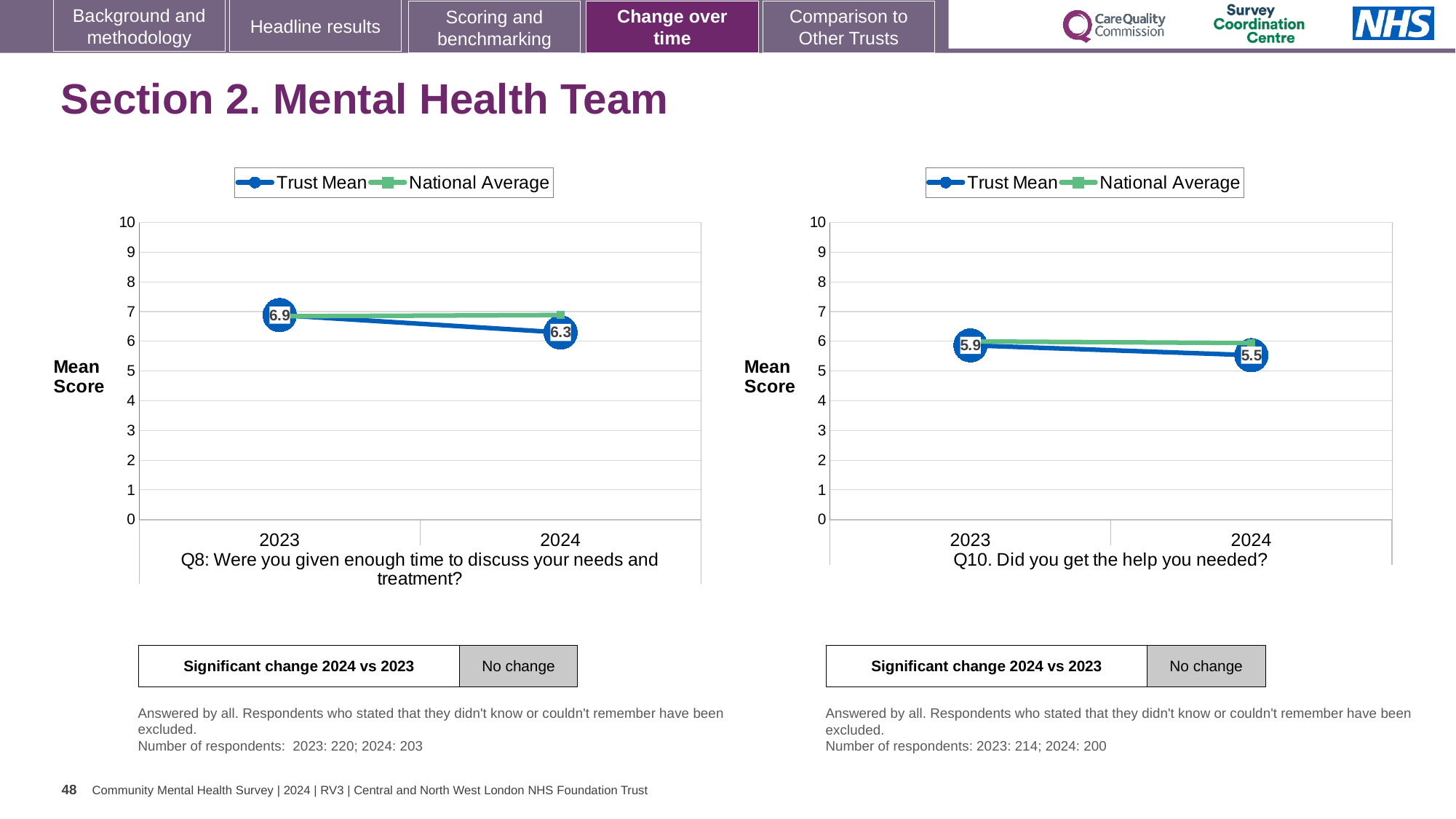
In the Q10 chart (right), what is the Trust Mean for 2024? 5.5 In the Q8 chart (left), what is the Trust Mean for 2023? 6.9 In the Q8 chart (left), what is the Trust Mean for 2024? 6.3 In the Q10 chart (right), which year has the higher Trust Mean, 2023 or 2024? 2023 What kind of chart is the Q10 chart (right)? line chart In the Q10 chart (right), what is the Trust Mean for 2023? 5.9 In the Q8 chart (left), what is the label of the y axis? Mean Score In the Q8 chart (left), does the Trust Mean rise or fall from 2023 to 2024? fall How many series does the legend of the Q8 chart (left) list? 2 In the Q10 chart (right), what is the difference between the Trust Mean in 2023 and 2024? 0.4 In the Q8 chart (left), by how much did the Trust Mean change from 2023 to 2024? 0.6 In the Q10 chart (right), is the National Average for 2024 greater or less than 5? greater